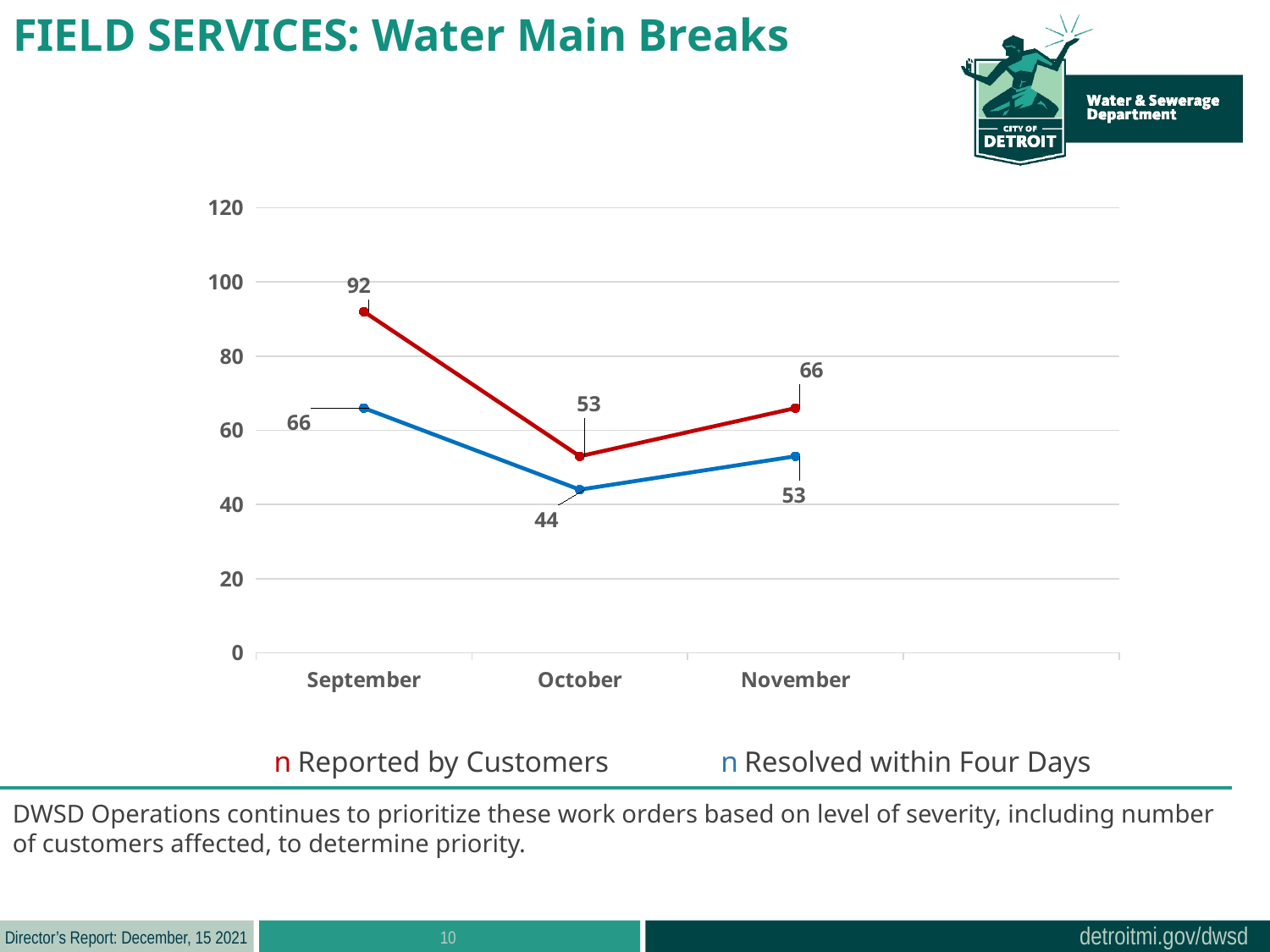
What is the value for Reported by Customers in September? 92 Does the Reported by Customers series rise or fall from September to October? fall Which is larger in October: Reported by Customers or Resolved within Four Days? Reported by Customers How many months are plotted on the x axis? 3 In which month is the Reported by Customers value highest? September What is the value for Reported by Customers in November? 66 How many series does the legend list? 2 What kind of chart is shown on the slide? line chart What is the value for Resolved within Four Days in October? 44 What is the difference between Reported by Customers and Resolved within Four Days in September? 26 In which month is the Resolved within Four Days value lowest? October What is the value for Resolved within Four Days in September? 66